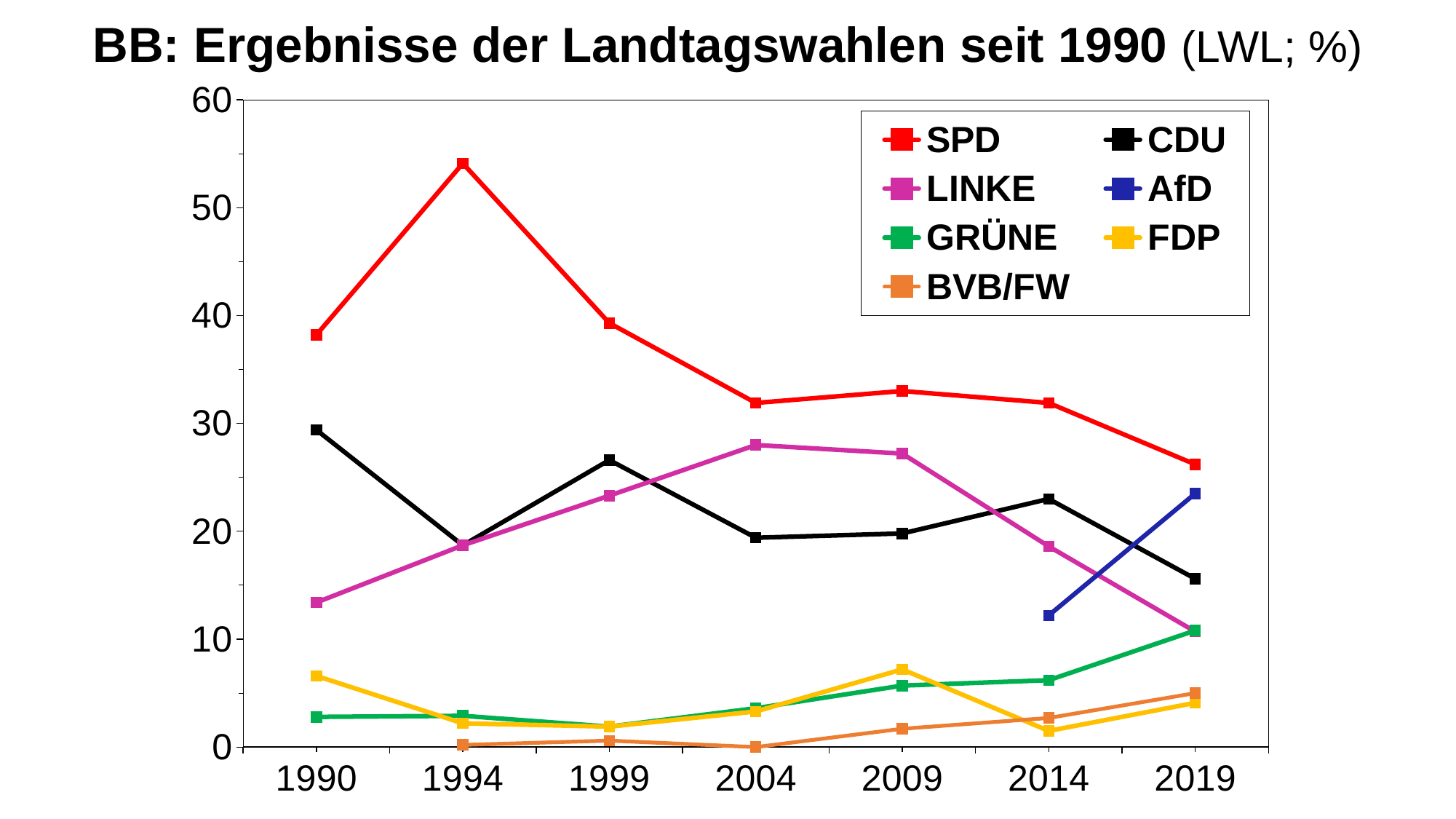
Which party has the highest value in 1994? SPD What kind of chart is shown on the slide? line chart Does the SPD line rise or fall from 1994 to 2019? falls In 1990, which is larger, the value for SPD or the value for CDU? SPD How many election years are shown on the x axis? 7 How many series does the legend list? 7 What is the title of the chart? BB: Ergebnisse der Landtagswahlen seit 1990 (LWL; %) Which party has the lowest value in 2004? BVB/FW In 2019, which is larger, the value for AfD or the value for CDU? AfD Is the value for CDU in 2019 greater or less than 20? less Is the value for LINKE in 2004 greater or less than 20? greater Is the value for SPD in 1994 greater or less than 50? greater